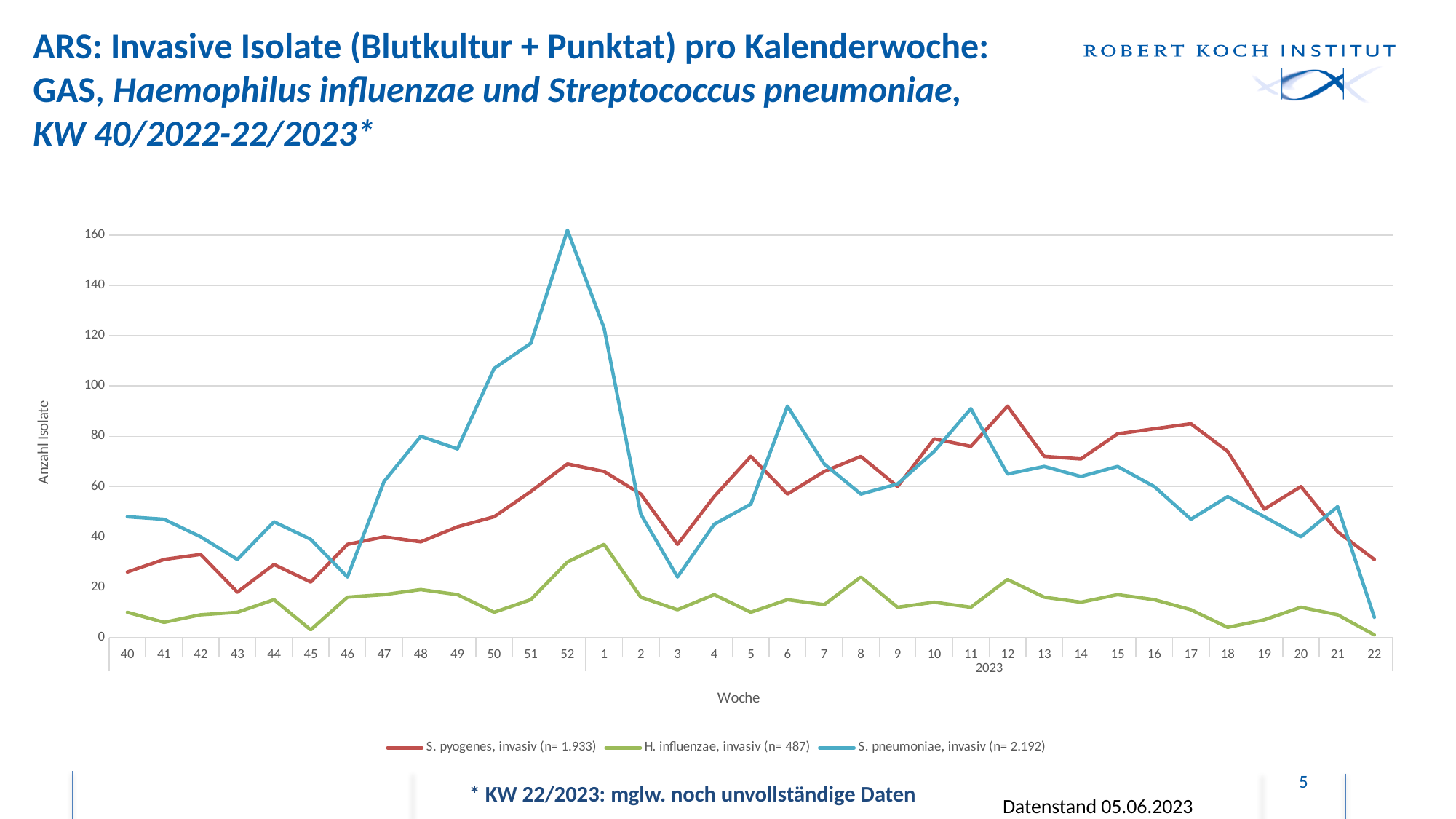
In which week does the S. pneumoniae, invasiv series reach its highest value? 52 In which week does the H. influenzae, invasiv series reach its lowest value? 22 How many series does the legend list? 3 Is the value for H. influenzae, invasiv in week 1 greater or less than 20? greater What is the label of the y axis? Anzahl Isolate Does the S. pneumoniae, invasiv series rise or fall from week 46 to week 52? rise In week 12, which series has the larger value: S. pyogenes, invasiv or S. pneumoniae, invasiv? S. pyogenes, invasiv What kind of chart is shown on the slide? line chart Is the value for S. pneumoniae, invasiv in week 52 greater or less than 140? greater In which week does the S. pyogenes, invasiv series reach its highest value? 12 Is the value for S. pneumoniae, invasiv in week 3 greater or less than 40? less How many calendar weeks are plotted along the x axis? 35